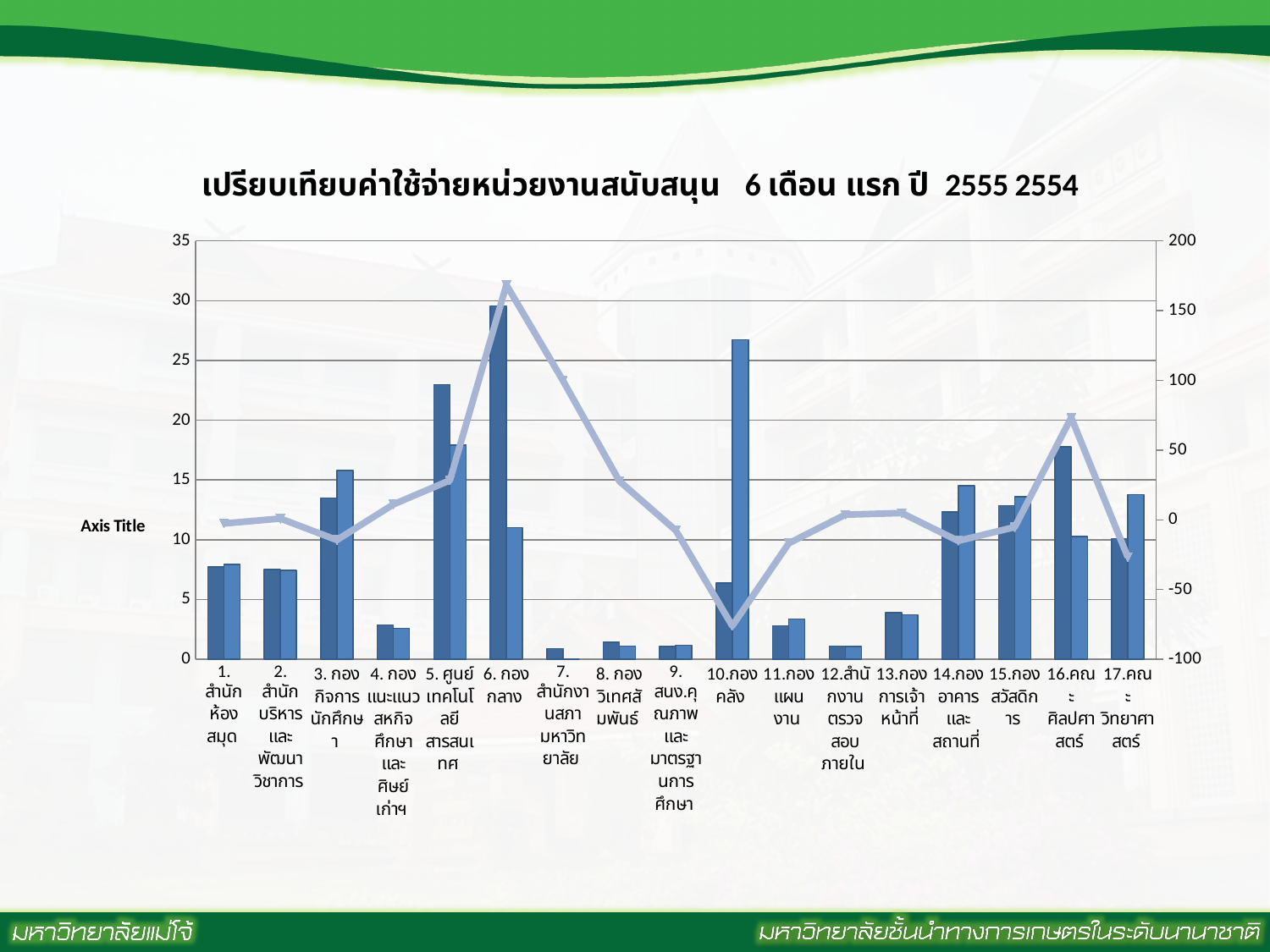
How many bars are plotted for each category? 2 At which category does the line reach its highest point? 6. กองกลาง Which category has the tallest dark blue bar? 6. กองกลาง Are the bars for 13.กองการเจ้าหน้าที่ greater or less than 5 on the left axis? less For 16.คณะศิลปศาสตร์, which bar is taller, the dark blue or the light blue one? The dark blue bar What kind of chart is shown on the slide? A bar chart combined with a line How many categories are shown along the x axis? 17 Which category has the tallest light blue bar? 10.กองคลัง Is the light blue bar for 10.กองคลัง greater or less than 25 on the left axis? greater At which category does the line reach its lowest point? 10.กองคลัง What is the highest value shown on the left vertical axis? 35 Is the dark blue bar for 5. ศูนย์เทคโนโลยีสารสนเทศ greater or less than 20 on the left axis? greater